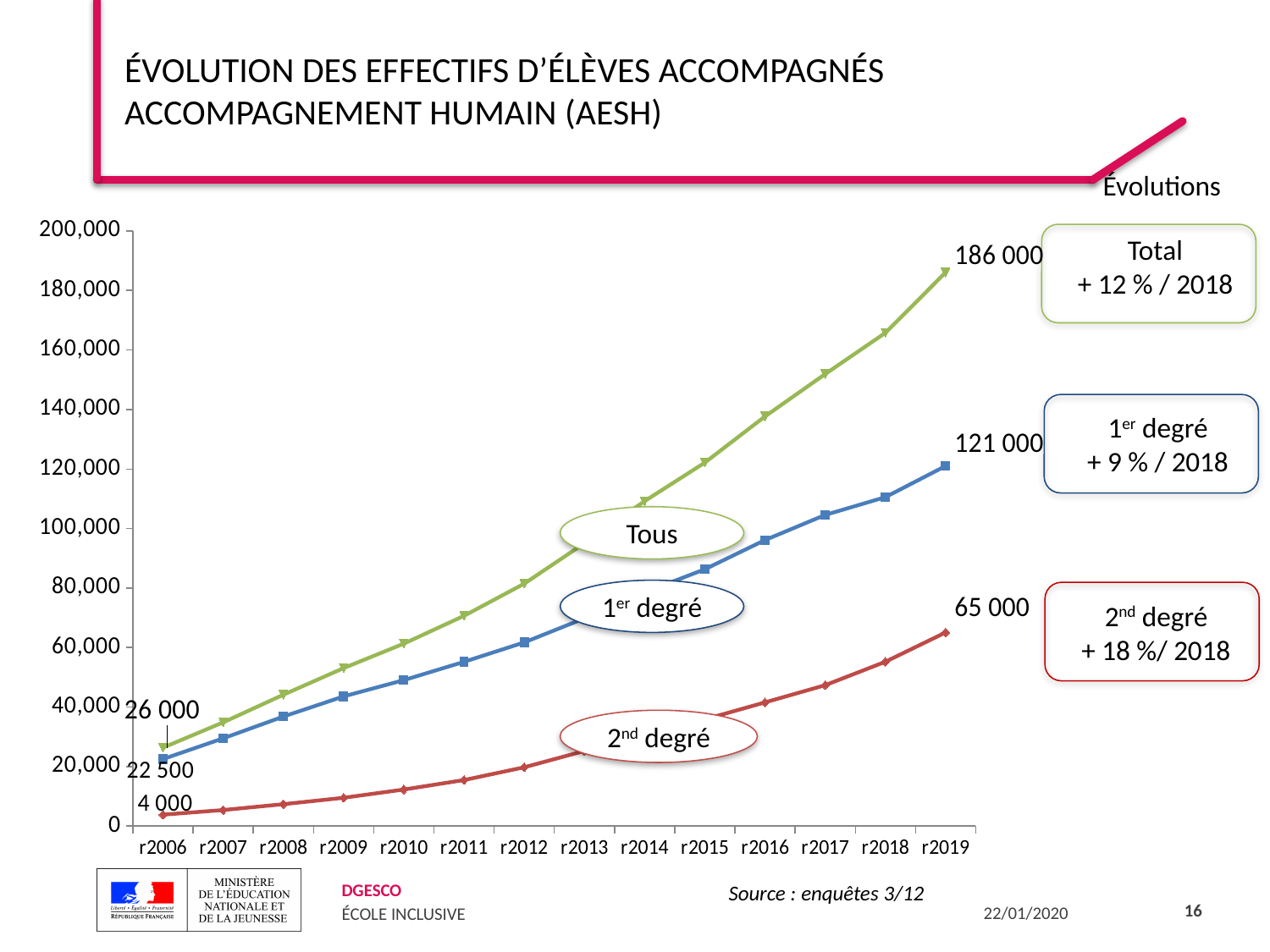
How many data series are plotted on the chart? 3 What is the value of the '2nd degré' series at r2006? 4 000 What kind of chart is shown on the slide? line chart What is the value of the '1er degré' series at r2019? 121 000 Do the values of the '2nd degré' series rise or fall from r2006 to r2019? rise What is the difference between the 'Tous' and '1er degré' values at r2006? 3 500 How many years (points) are shown along the x axis of the chart? 14 What is the value of the 'Tous' series at r2019? 186 000 What is the value of the '1er degré' series at r2006? 22 500 Which series has the highest value at r2019? Tous What is the difference between the 'Tous' and '1er degré' values at r2019? 65 000 Is the value of the 'Tous' series at r2017 greater or less than 140,000? greater